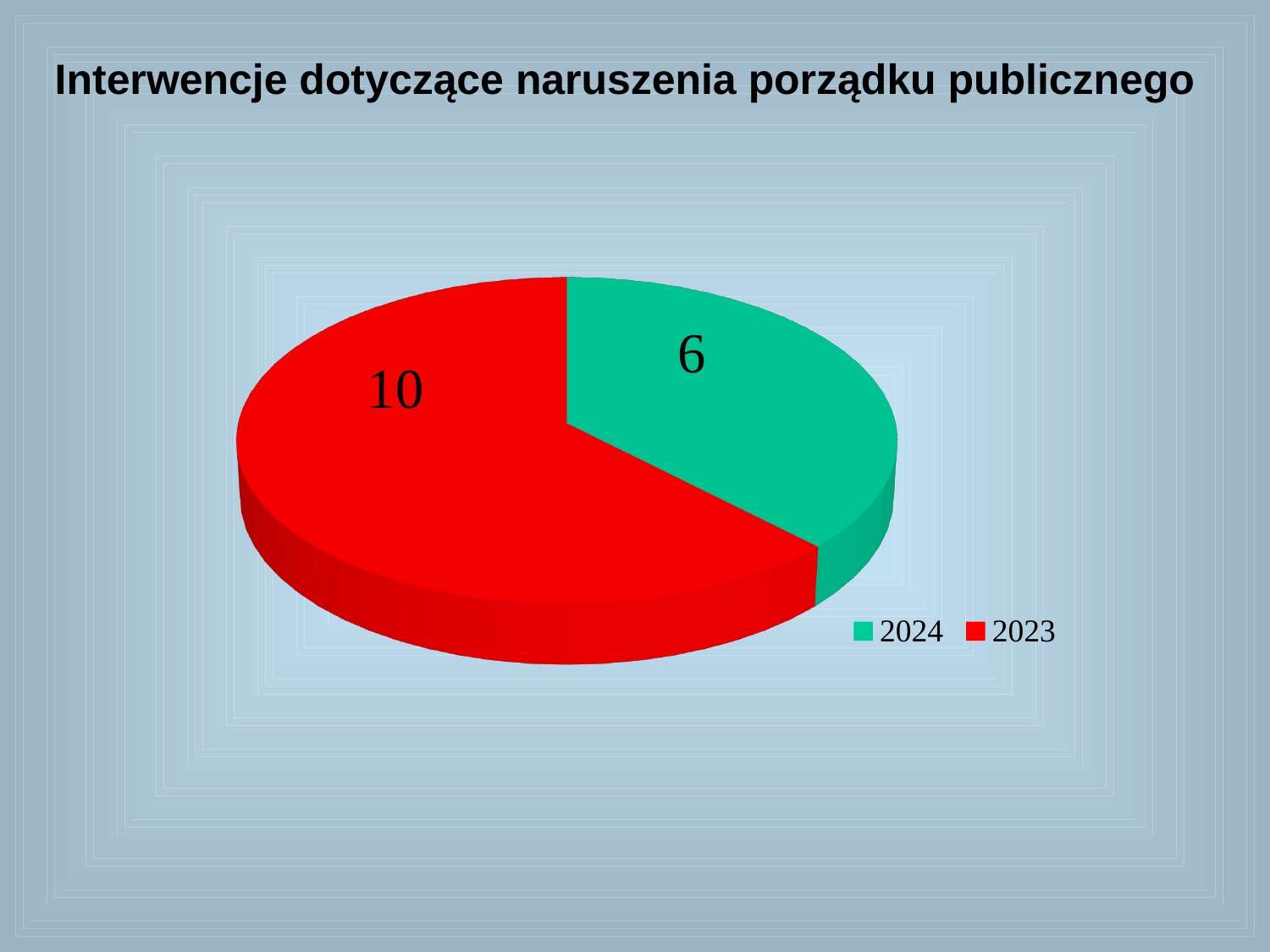
What is the total of the two slices? 16 How many entries does the legend list? 2 What share of the pie does the 2023 slice represent? 62.5% What kind of chart is shown on the slide? pie chart What is the value for 2023? 10 What colour is the slice for 2024? green What is the difference between the values for 2023 and 2024? 4 Is the value for 2023 larger or smaller than the value for 2024? larger Which year has the smaller slice? 2024 How many slices does the pie chart have? 2 What is the value for 2024? 6 Which year has the larger slice? 2023